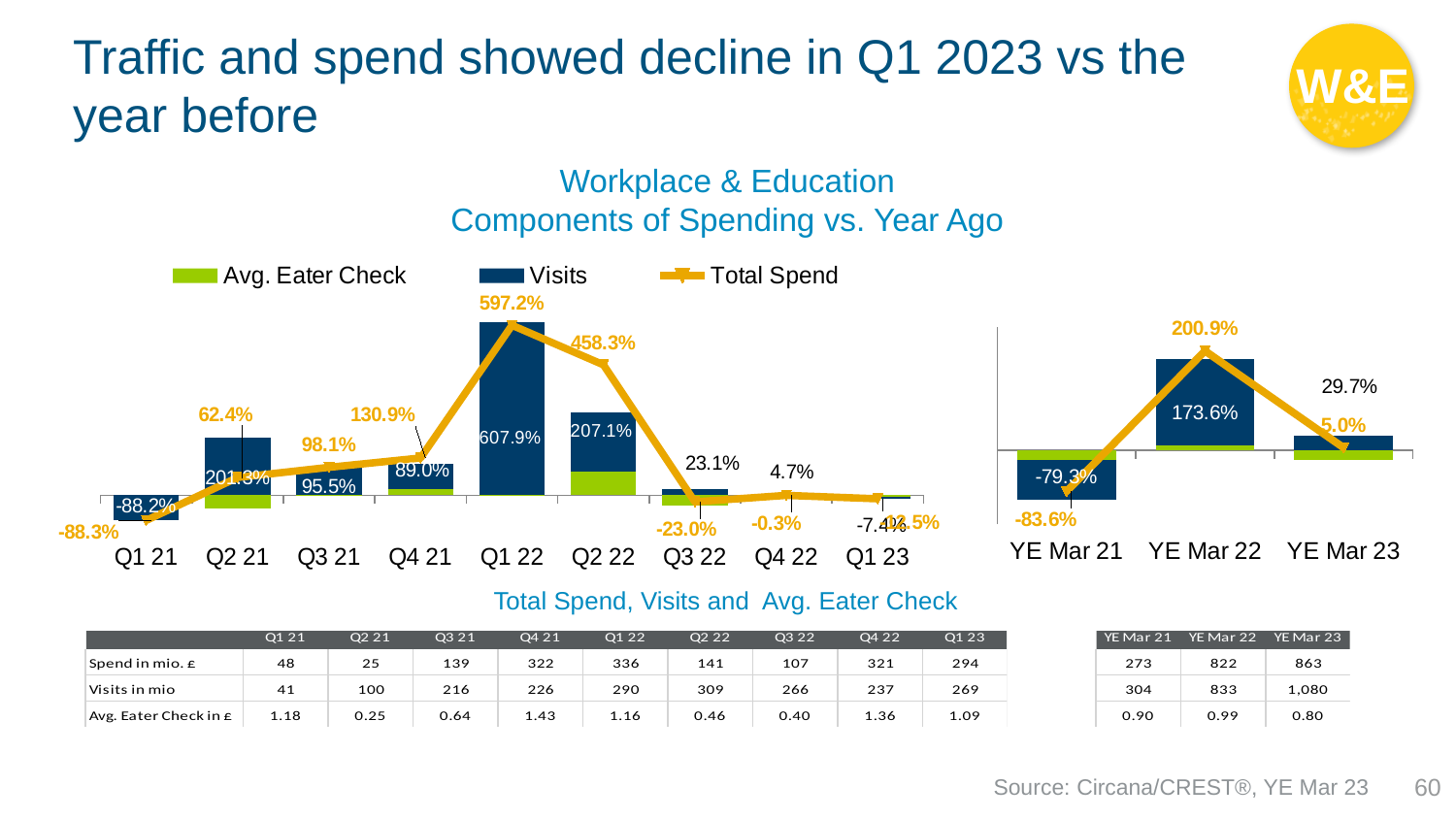
On the right yearly chart, what is the Total Spend value for YE Mar 22? 200.9% How many series does the legend list? 3 What kind of chart is the left quarterly chart? Stacked bar chart with a line On the left quarterly chart, what is the difference between the Total Spend values for Q1 22 and Q2 22? 138.9 percentage points On the right yearly chart, what is the Visits value for YE Mar 23? 29.7% On the left quarterly chart, what is the Total Spend value for Q2 22? 458.3% On the left quarterly chart, which quarter has the highest Total Spend value? Q1 22 On the right yearly chart, does the Total Spend line rise or fall from YE Mar 22 to YE Mar 23? Fall On the left quarterly chart, how many quarters are shown on the x axis? 9 On the left quarterly chart, what is the Total Spend value for Q1 22? 597.2% On the left quarterly chart, what is the Visits value for Q1 22? 607.9% On the left quarterly chart, which quarter has the lowest Total Spend value? Q1 21